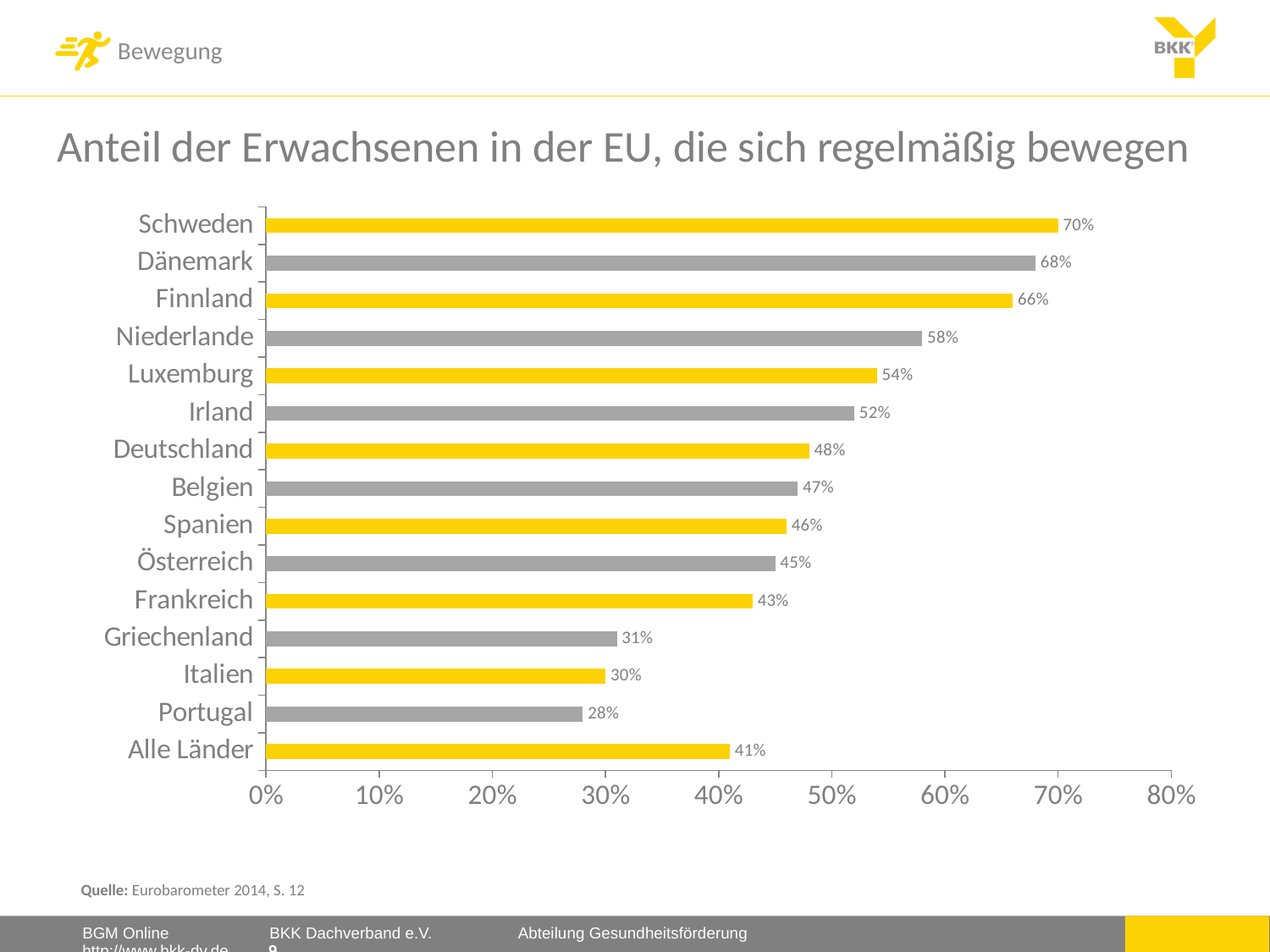
What is the difference between the values for Deutschland and Alle Länder? 7% What is the value for Deutschland? 48% What kind of chart is shown on the slide? bar chart Which has a larger value, Niederlande or Irland? Niederlande How many categories are shown on the chart? 15 Which country has the highest share of adults who exercise regularly? Schweden What is the difference between the values for Schweden and Portugal? 42% Which category has the lowest value? Portugal What is the title of the chart? Anteil der Erwachsenen in der EU, die sich regelmäßig bewegen What is the value for Alle Länder? 41% Is the value for Luxemburg greater or less than 50%? greater What is the value for Griechenland? 31%